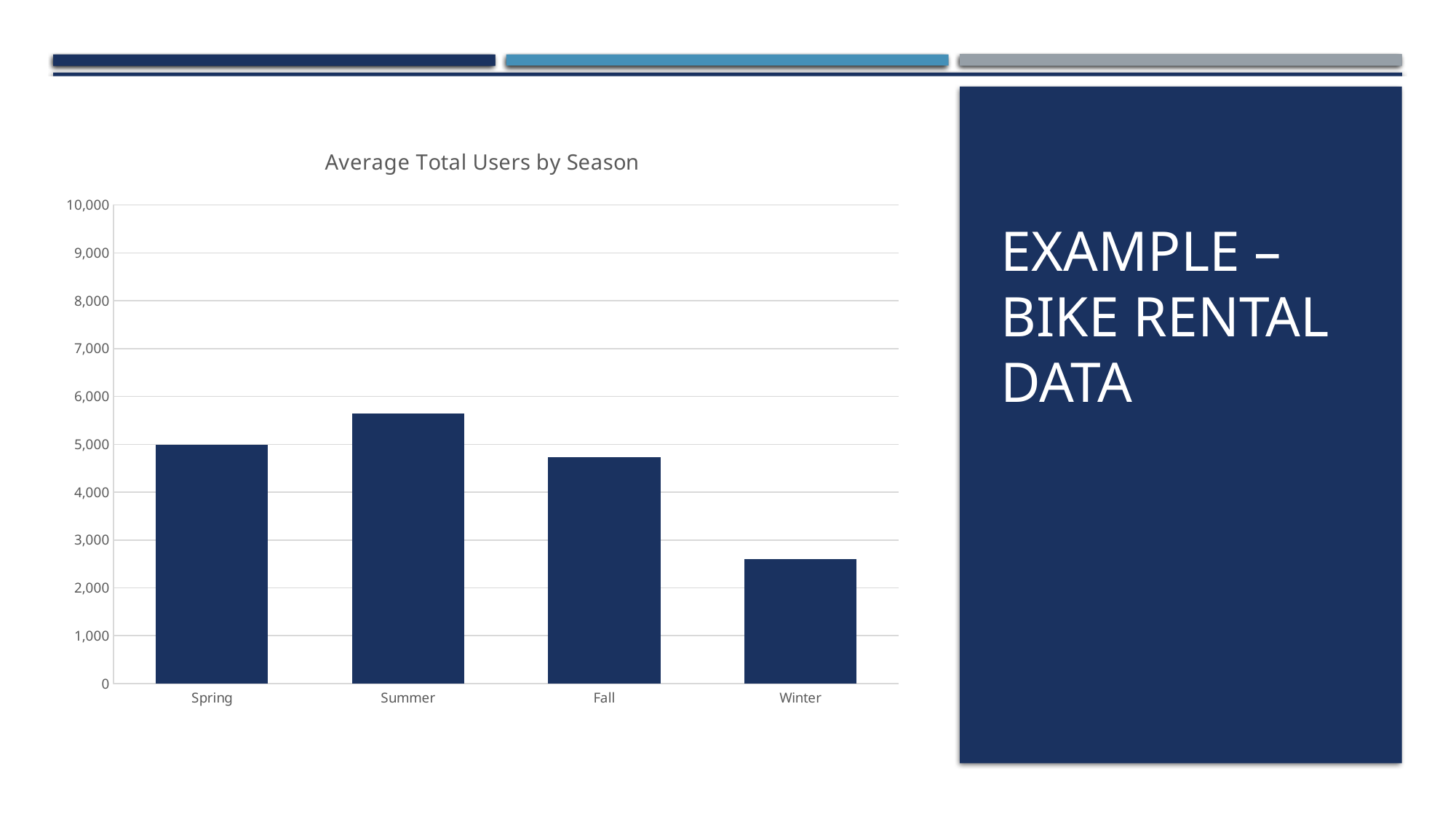
Is the value for Winter greater or less than 2,000? greater Do the values rise or fall from Summer to Winter along the x axis? fall Is the value for Winter greater or less than 3,000? less Which season has the lowest average total users? Winter Is the value for Fall greater or less than 5,000? less What is the title of the chart? Average Total Users by Season Which has more average total users, Summer or Fall? Summer Which season has the highest average total users? Summer Which has more average total users, Spring or Winter? Spring How many seasons are plotted in the chart? 4 What kind of chart is shown on the slide? Bar chart